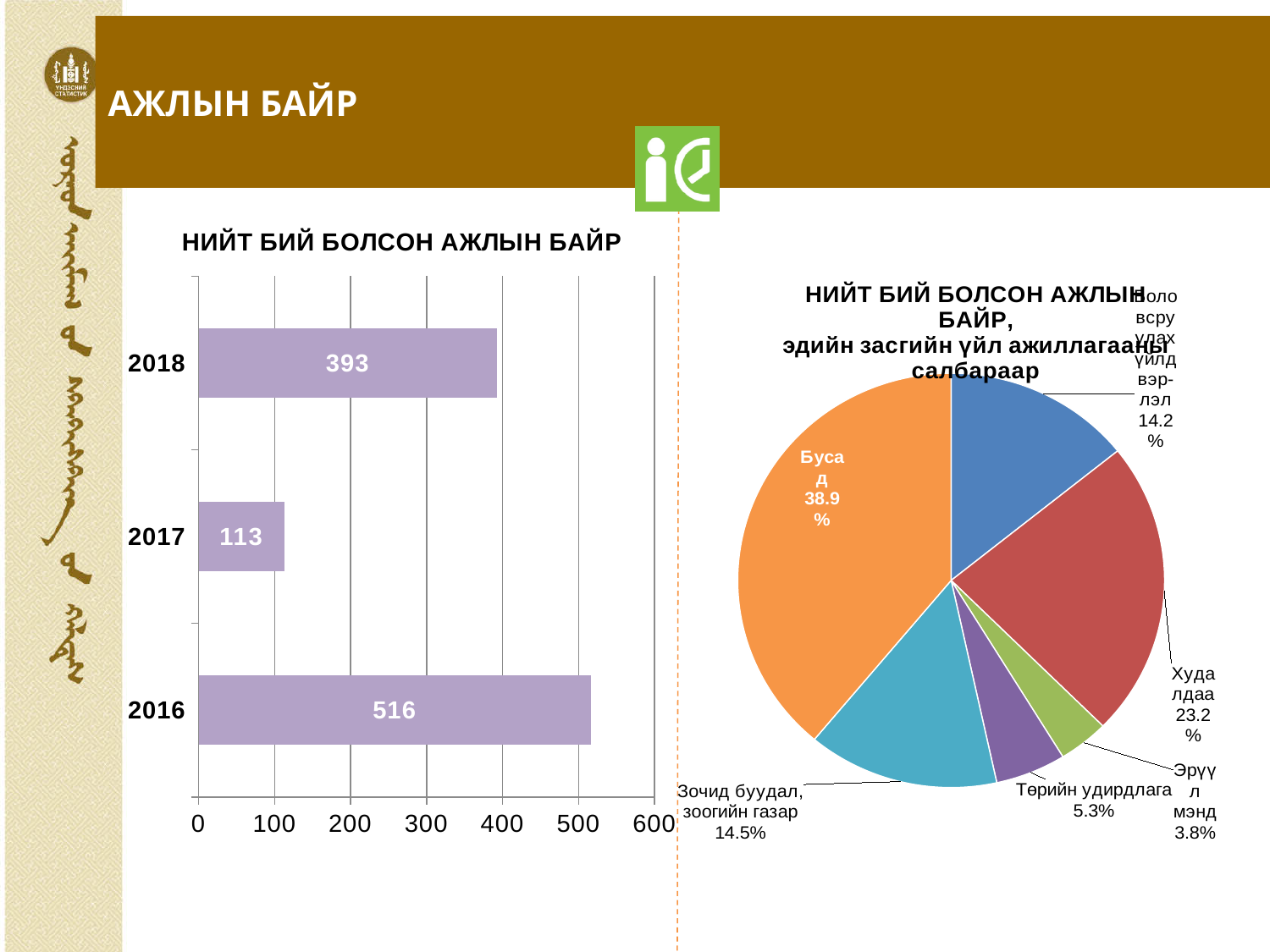
In the bar chart 'НИЙТ БИЙ БОЛСОН АЖЛЫН БАЙР', what is the difference between the values for 2016 and 2018? 123 In the bar chart 'НИЙТ БИЙ БОЛСОН АЖЛЫН БАЙР', which year has the highest value? 2016 In the pie chart on the right, what share does 'Бусад' have? 38.9% In the pie chart on the right, which slice is the smallest? Эрүүл мэнд In the bar chart 'НИЙТ БИЙ БОЛСОН АЖЛЫН БАЙР', what is the value for 2018? 393 In the bar chart 'НИЙТ БИЙ БОЛСОН АЖЛЫН БАЙР', which year has the lowest value? 2017 In the pie chart on the right, which is larger: 'Төрийн удирдлага' or 'Зочид буудал, зоогийн газар'? Зочид буудал, зоогийн газар In the bar chart 'НИЙТ БИЙ БОЛСОН АЖЛЫН БАЙР', what is the value for 2017? 113 What kind of chart is the left chart 'НИЙТ БИЙ БОЛСОН АЖЛЫН БАЙР'? bar chart In the bar chart 'НИЙТ БИЙ БОЛСОН АЖЛЫН БАЙР', what is the value for 2016? 516 In the bar chart 'НИЙТ БИЙ БОЛСОН АЖЛЫН БАЙР', how many years are shown? 3 In the pie chart on the right, what share does 'Худалдаа' have? 23.2%